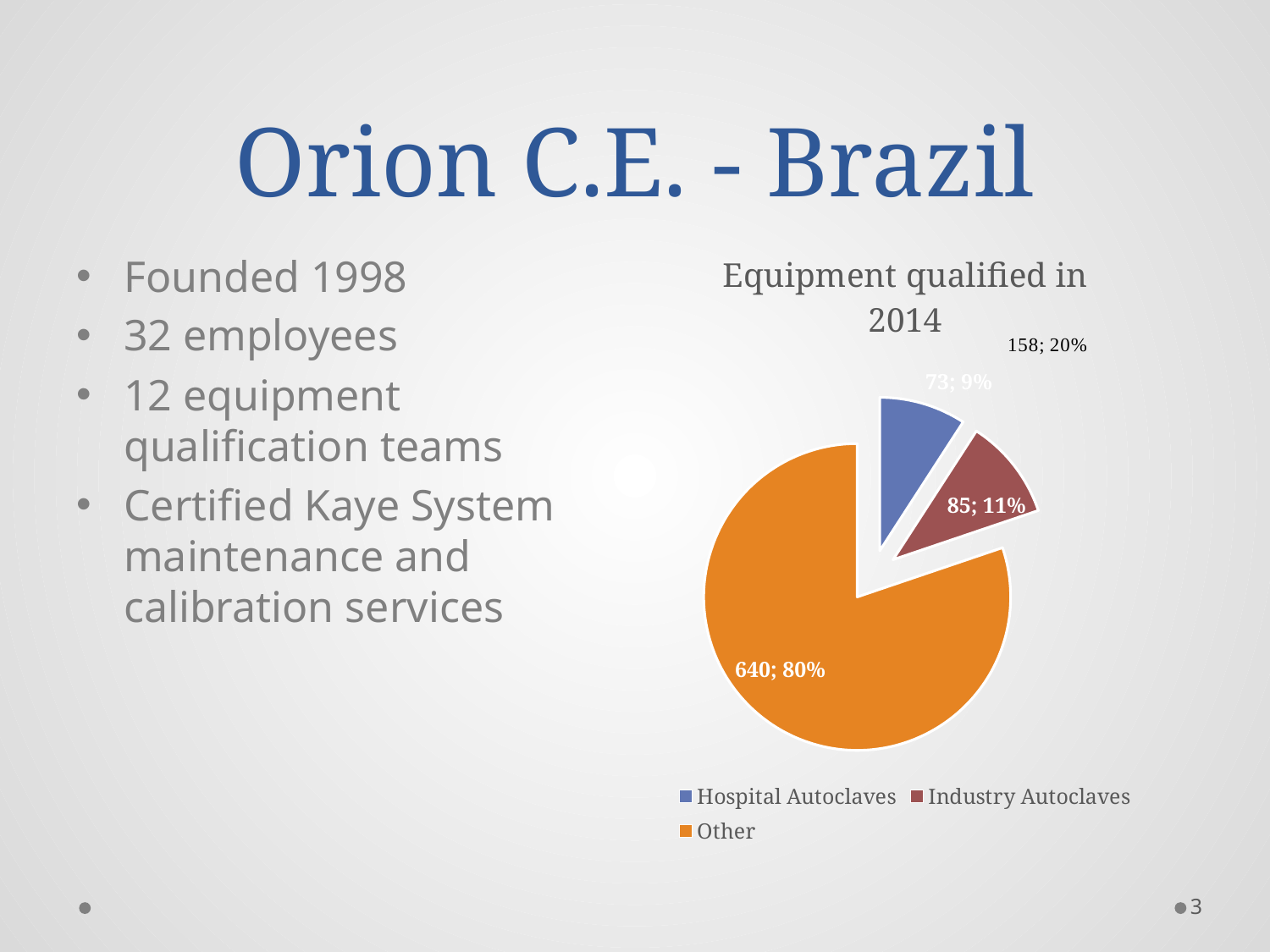
Which colour represents Industry Autoclaves in the chart? red What value is shown for Other? 640 What value is shown for Industry Autoclaves? 85 What is the difference between the values for Other and Industry Autoclaves? 555 Which category has the smallest slice? Hospital Autoclaves How many entries does the chart legend list? 3 Which category has the largest slice? Other What kind of chart is shown on the slide? pie chart What share of the pie does Hospital Autoclaves represent? 9% What value is shown for Hospital Autoclaves? 73 What is the title of the chart? Equipment qualified in 2014 What share of the pie does Other represent? 80%